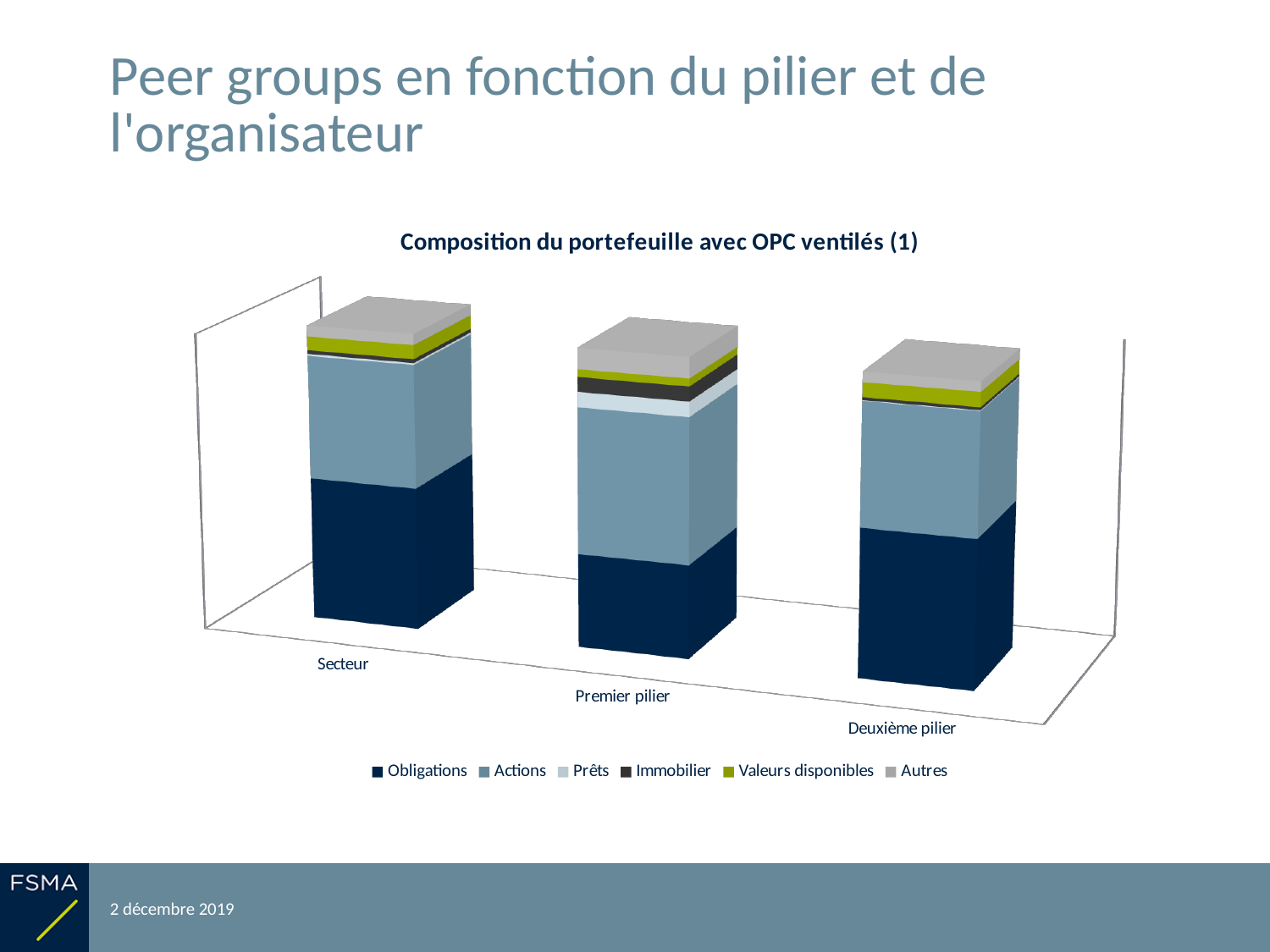
Which series is listed first in the chart's legend? Obligations What is the title of the chart? Composition du portefeuille avec OPC ventilés (1) Which category has the largest Immobilier segment? Premier pilier Which category has the largest Prêts segment? Premier pilier What are the three categories shown along the x axis of the chart? Secteur, Premier pilier, Deuxième pilier How many categories are shown on the x axis of the chart? 3 In the Premier pilier bar, which segment is larger: Actions or Obligations? Actions What kind of chart is shown on the slide? Stacked bar chart How many series does the chart's legend list? 6